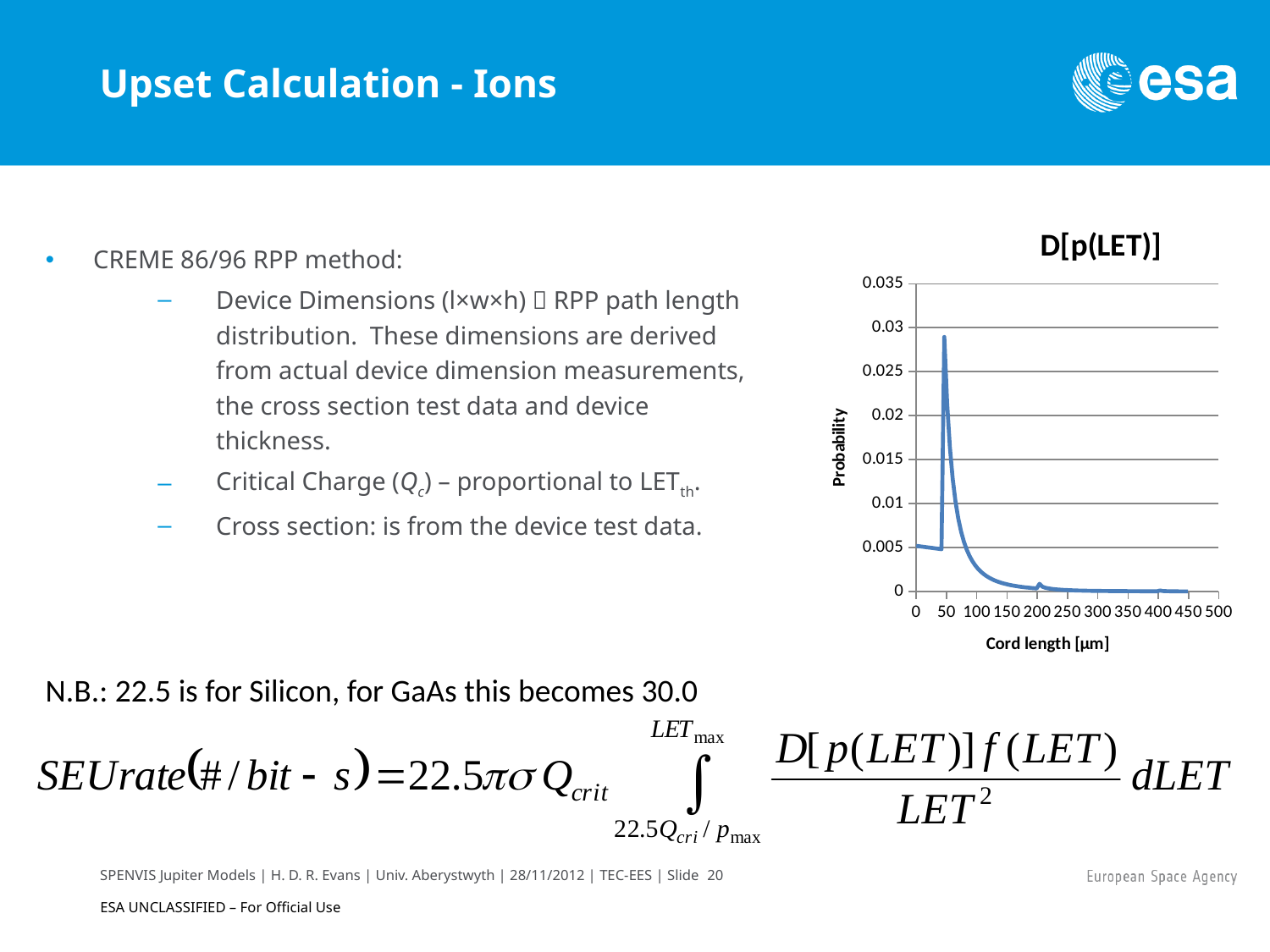
Which has the higher probability: a cord length of 50 μm or a cord length of 200 μm? 50 μm What is the label of the x axis of the chart? Cord length [μm] Is the peak value of the curve greater or less than 0.025? greater Is the probability at a cord length of 100 μm greater or less than 0.01? less Is the probability at a cord length of 0 μm greater or less than 0.01? less Does the probability rise or fall as cord length increases from 50 μm to 500 μm? fall What is the title of the chart on the slide? D[p(LET)] What kind of chart is shown on the slide? line chart What is the maximum value shown on the y axis of the chart? 0.035